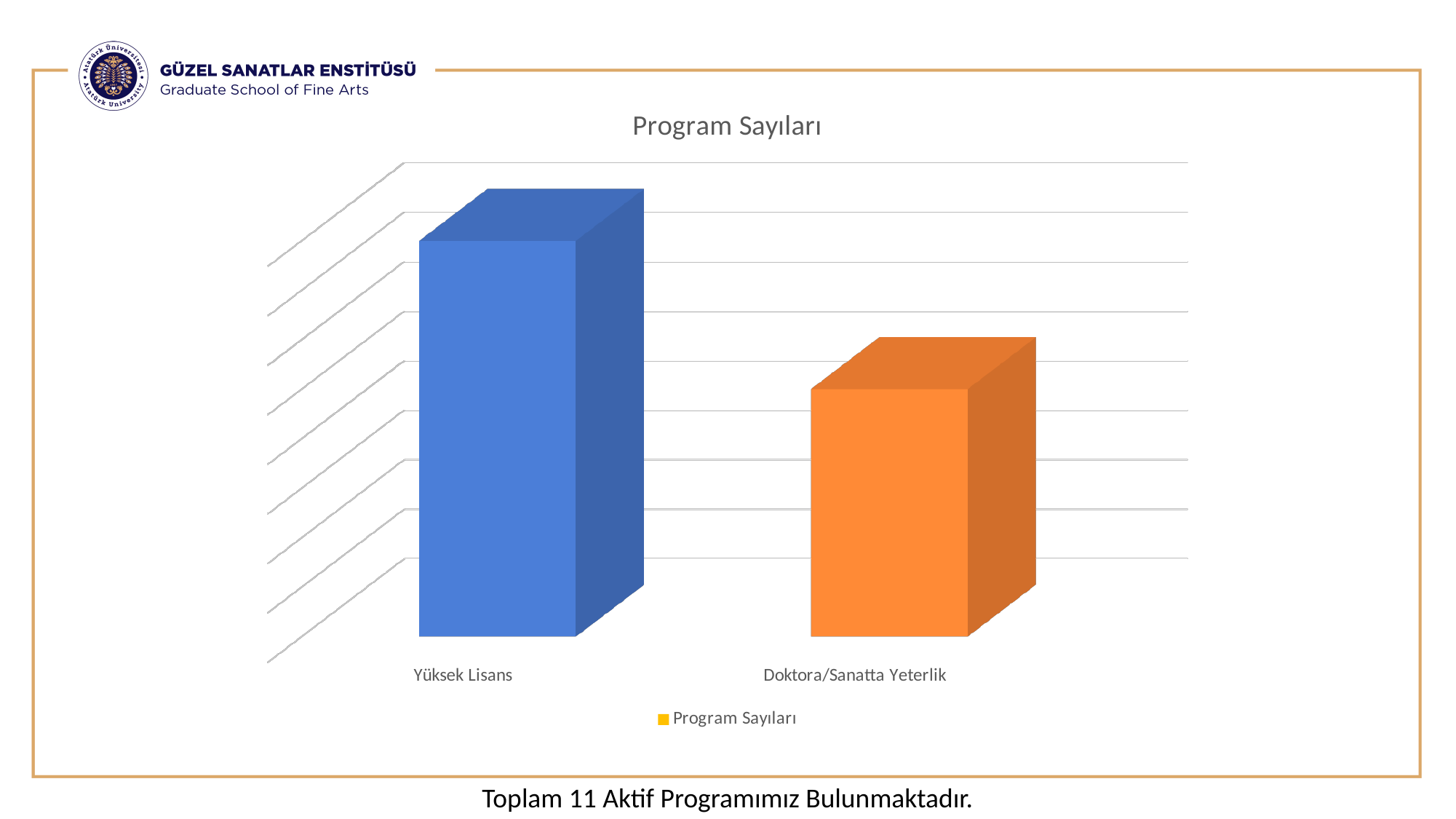
How many categories are shown on the x axis of the chart? 2 Which category has the lowest bar in the chart? Doktora/Sanatta Yeterlik Which category has the highest bar in the chart? Yüksek Lisans What kind of chart is shown on the slide? bar chart Which is larger, the bar for Yüksek Lisans or the bar for Doktora/Sanatta Yeterlik? Yüksek Lisans What series name is shown in the chart legend? Program Sayıları What is the title of the chart? Program Sayıları How many series does the chart legend list? 1